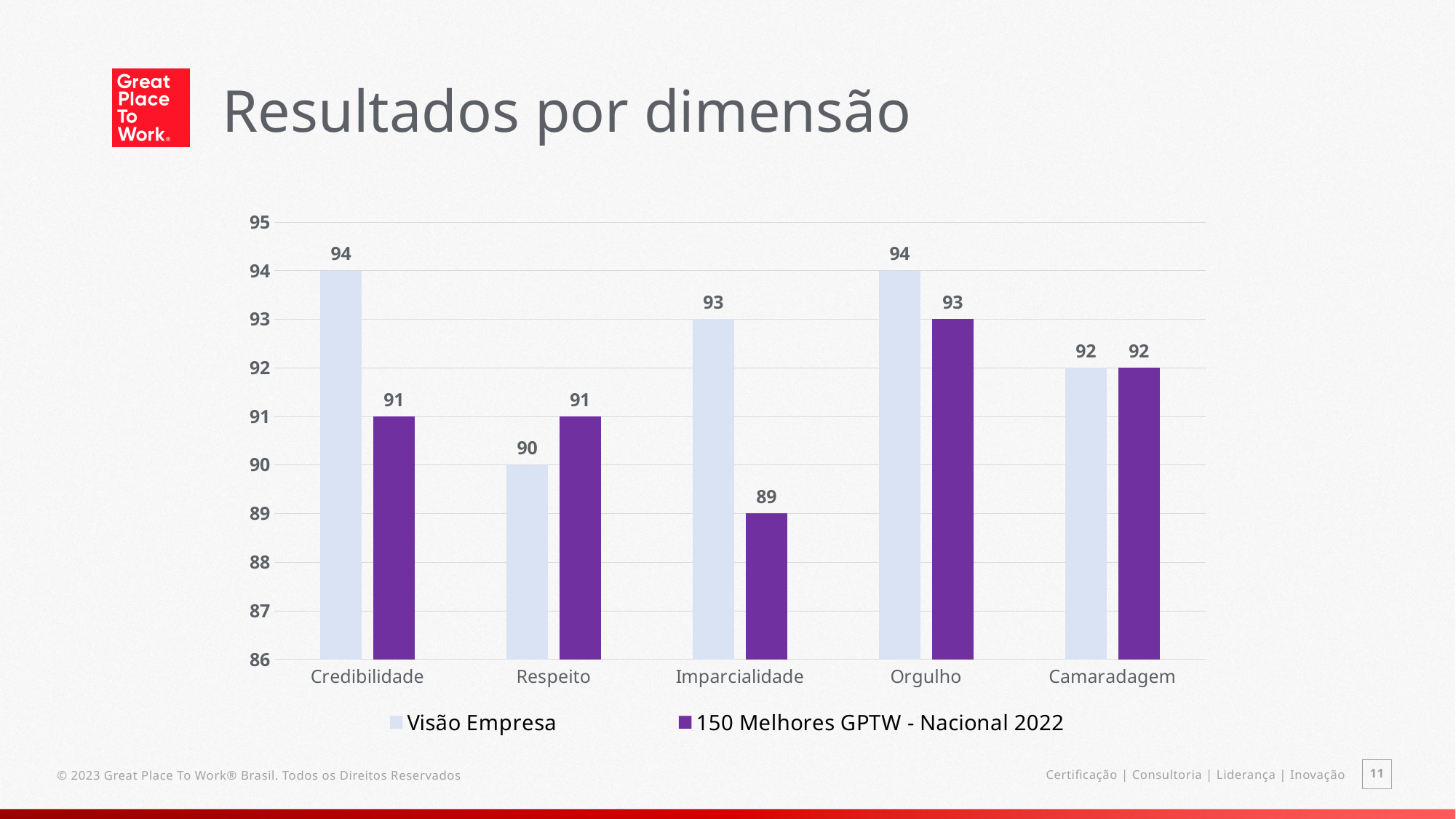
How many categories are shown on the x axis? 5 How many series does the legend list? 2 What is the difference between the Visão Empresa and 150 Melhores GPTW - Nacional 2022 values for Imparcialidade? 4 For Respeito, which series has the larger value, Visão Empresa or 150 Melhores GPTW - Nacional 2022? 150 Melhores GPTW - Nacional 2022 What kind of chart is shown on the slide? Bar chart What is the 150 Melhores GPTW - Nacional 2022 value for Imparcialidade? 89 What is the title of the slide? Resultados por dimensão Which category has the lowest 150 Melhores GPTW - Nacional 2022 value? Imparcialidade What is the Visão Empresa value for Respeito? 90 What is the Visão Empresa value for Credibilidade? 94 What is the difference between the Visão Empresa and 150 Melhores GPTW - Nacional 2022 values for Credibilidade? 3 Which category has the lowest Visão Empresa value? Respeito